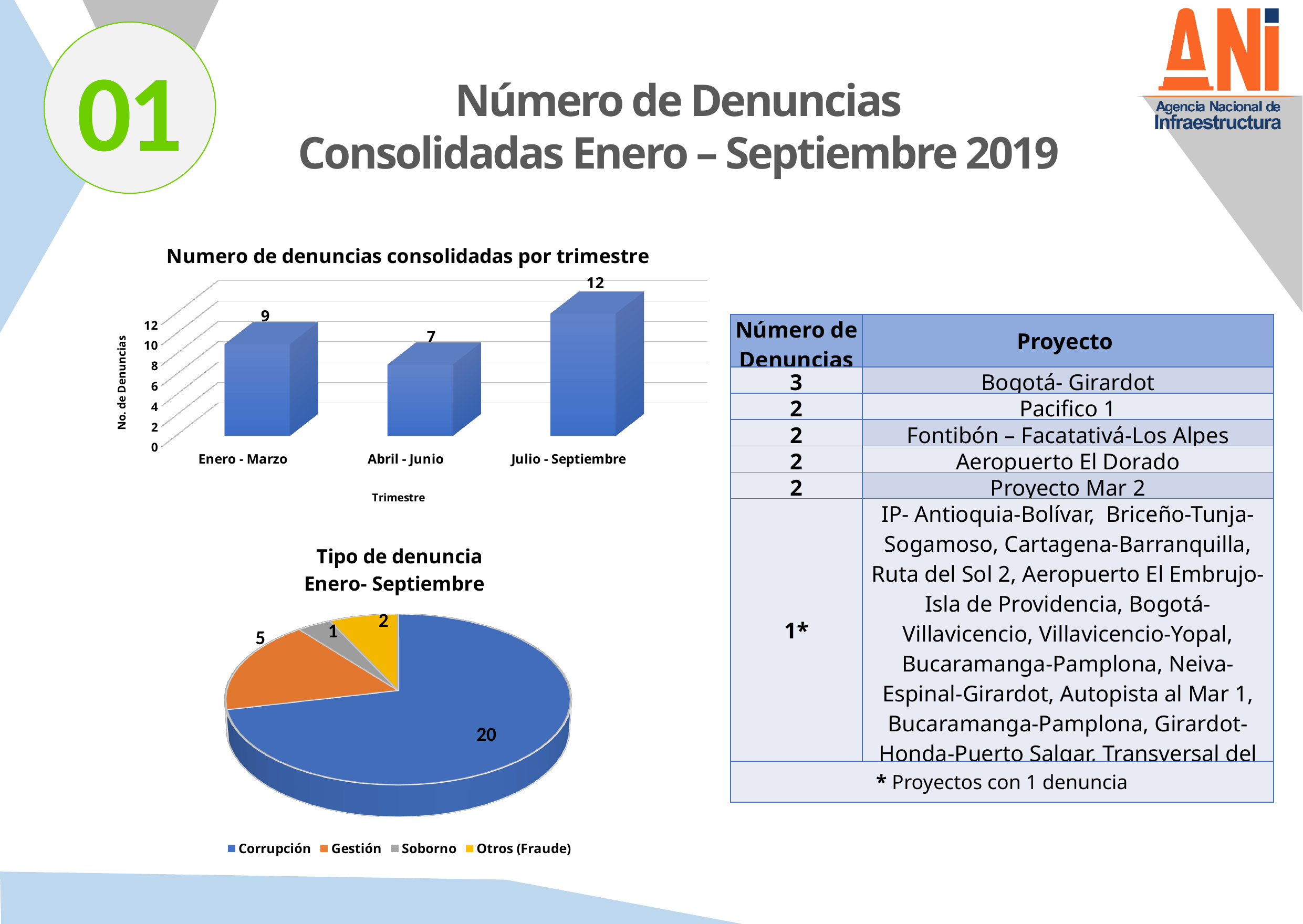
What kind of chart is 'Numero de denuncias consolidadas por trimestre'? Bar chart In the chart 'Numero de denuncias consolidadas por trimestre', which quarter has the highest number of denuncias? Julio - Septiembre In the pie chart 'Tipo de denuncia Enero- Septiembre', which is larger, Gestión or Otros (Fraude)? Gestión In the chart 'Numero de denuncias consolidadas por trimestre', how many quarters are shown? 3 In the chart 'Numero de denuncias consolidadas por trimestre', what is the difference between Julio - Septiembre and Abril - Junio? 5 In the chart 'Numero de denuncias consolidadas por trimestre', what is the value for Abril - Junio? 7 In the chart 'Numero de denuncias consolidadas por trimestre', what is the value for Enero - Marzo? 9 In the chart 'Numero de denuncias consolidadas por trimestre', which quarter has the lowest number of denuncias? Abril - Junio How many categories does the legend of the pie chart 'Tipo de denuncia Enero- Septiembre' list? 4 In the pie chart 'Tipo de denuncia Enero- Septiembre', which type has the largest slice? Corrupción In the pie chart 'Tipo de denuncia Enero- Septiembre', what is the value for Gestión? 5 In the pie chart 'Tipo de denuncia Enero- Septiembre', what is the value for Soborno? 1